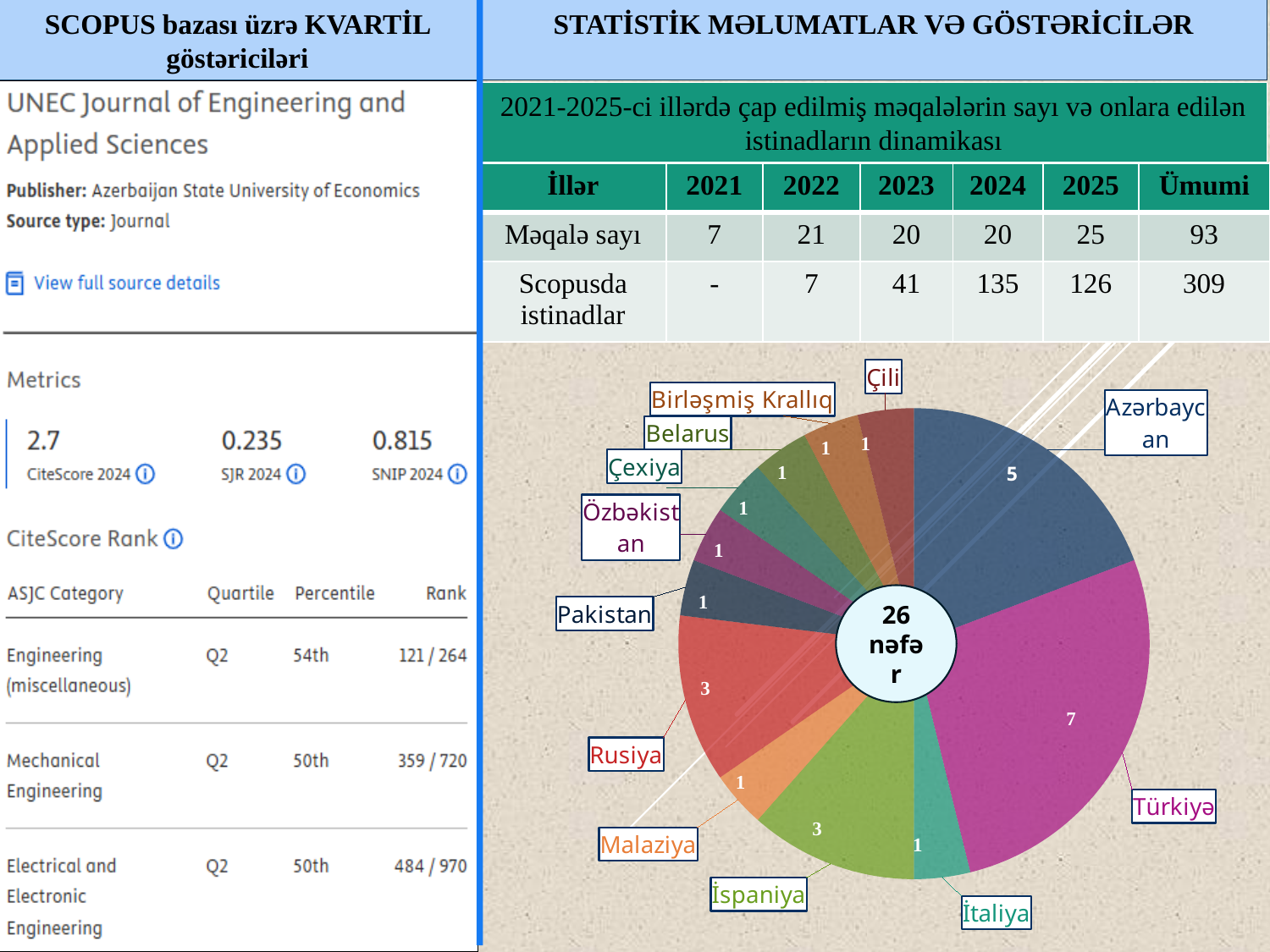
What is the total of all slices in the pie chart? 26 How many countries are shown as slices in the pie chart? 12 Which country has the largest slice in the pie chart? Türkiyə In the pie chart, what is the difference between the values for Türkiyə and Azərbaycan? 2 In the pie chart, what is the value for Azərbaycan? 5 What kind of chart is shown on the right side of the slide? pie chart In the pie chart, what is the value for Pakistan? 1 In the pie chart, which is larger, the value for Rusiya or the value for Malaziya? Rusiya In the pie chart, what is the difference between the values for İspaniya and İtaliya? 2 In the pie chart, what is the value for İspaniya? 3 What text is written in the centre of the pie chart? 26 nəfər In the pie chart, what is the value for Türkiyə? 7